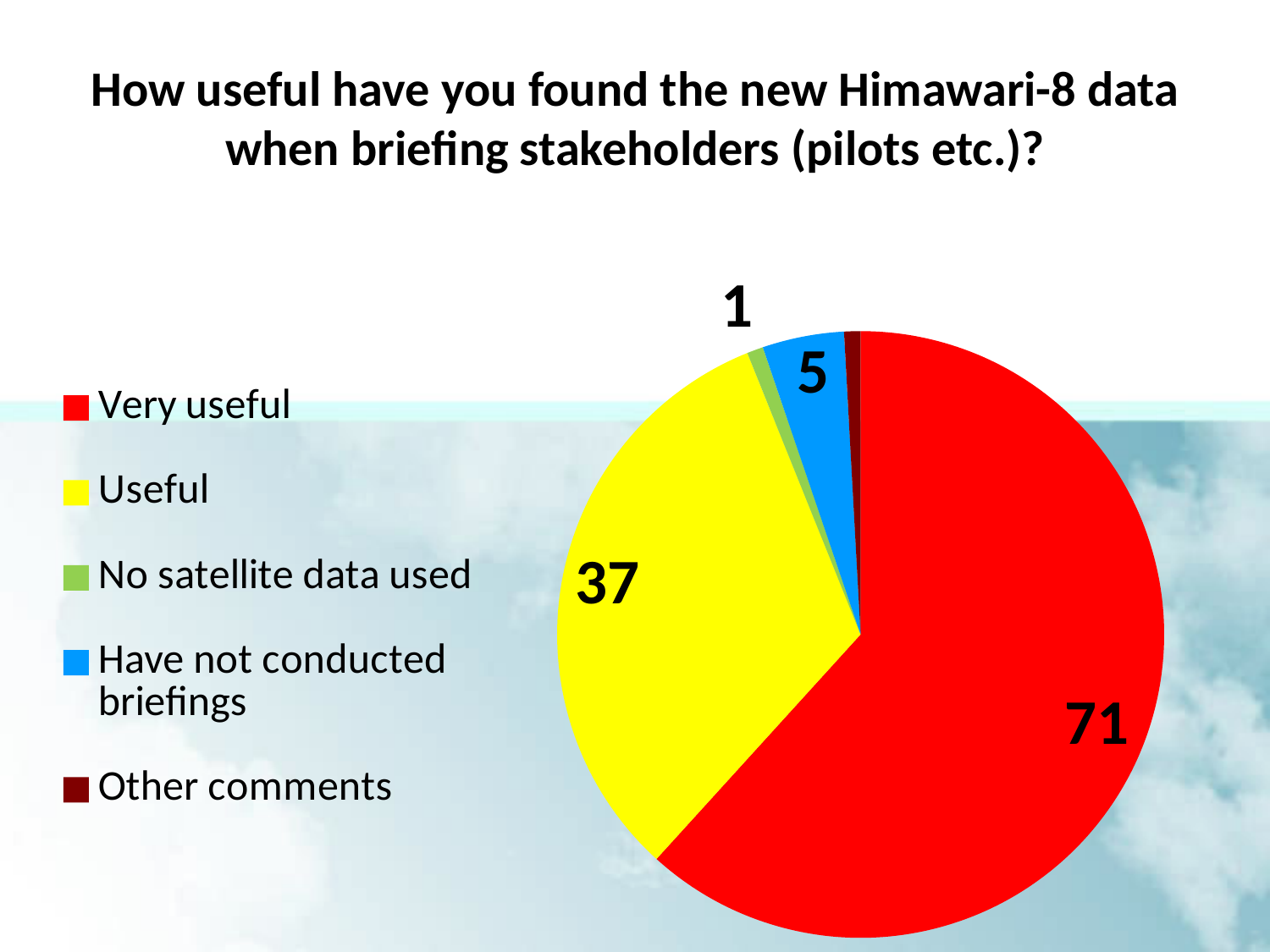
What colour is the slice for Useful? yellow How many categories does the legend list? 5 What is the value for Very useful? 71 What is the difference between the values for Have not conducted briefings and No satellite data used? 4 Which category has the largest slice of the pie? Very useful What is the value for Useful? 37 What is the value for No satellite data used? 1 What is the value for Have not conducted briefings? 5 Which is larger, the value for Useful or the value for Have not conducted briefings? Useful What is the title of the chart? How useful have you found the new Himawari-8 data when briefing stakeholders (pilots etc.)? What is the difference between the values for Very useful and Useful? 34 What kind of chart is shown on the slide? pie chart